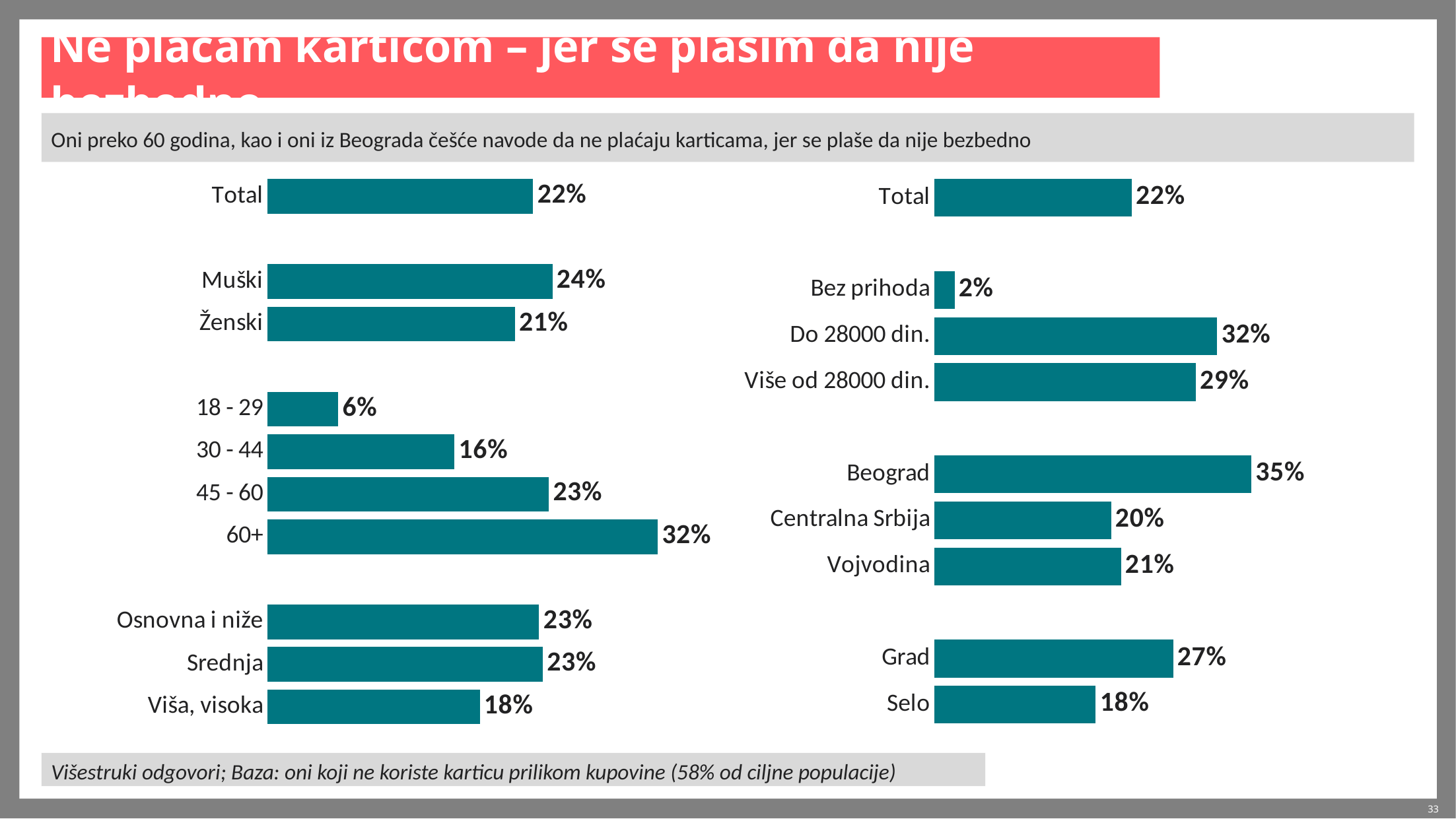
In the right chart, what is the value for Beograd? 35% How many categories does the right chart show? 9 In the right chart, which category has the highest value? Beograd In the right chart, which is larger, Do 28000 din. or Više od 28000 din.? Do 28000 din. In the left chart, which is larger, 30 - 44 or 45 - 60? 45 - 60 In the right chart, what is the difference between Grad and Selo? 9% In the right chart, what is the value for Bez prihoda? 2% What type of chart is the left chart? bar chart In the left chart, what is the value for 60+? 32% In the left chart, which category has the lowest value? 18 - 29 In the left chart, what is the difference between 60+ and 18 - 29? 26% In the left chart, what is the value for Muški? 24%